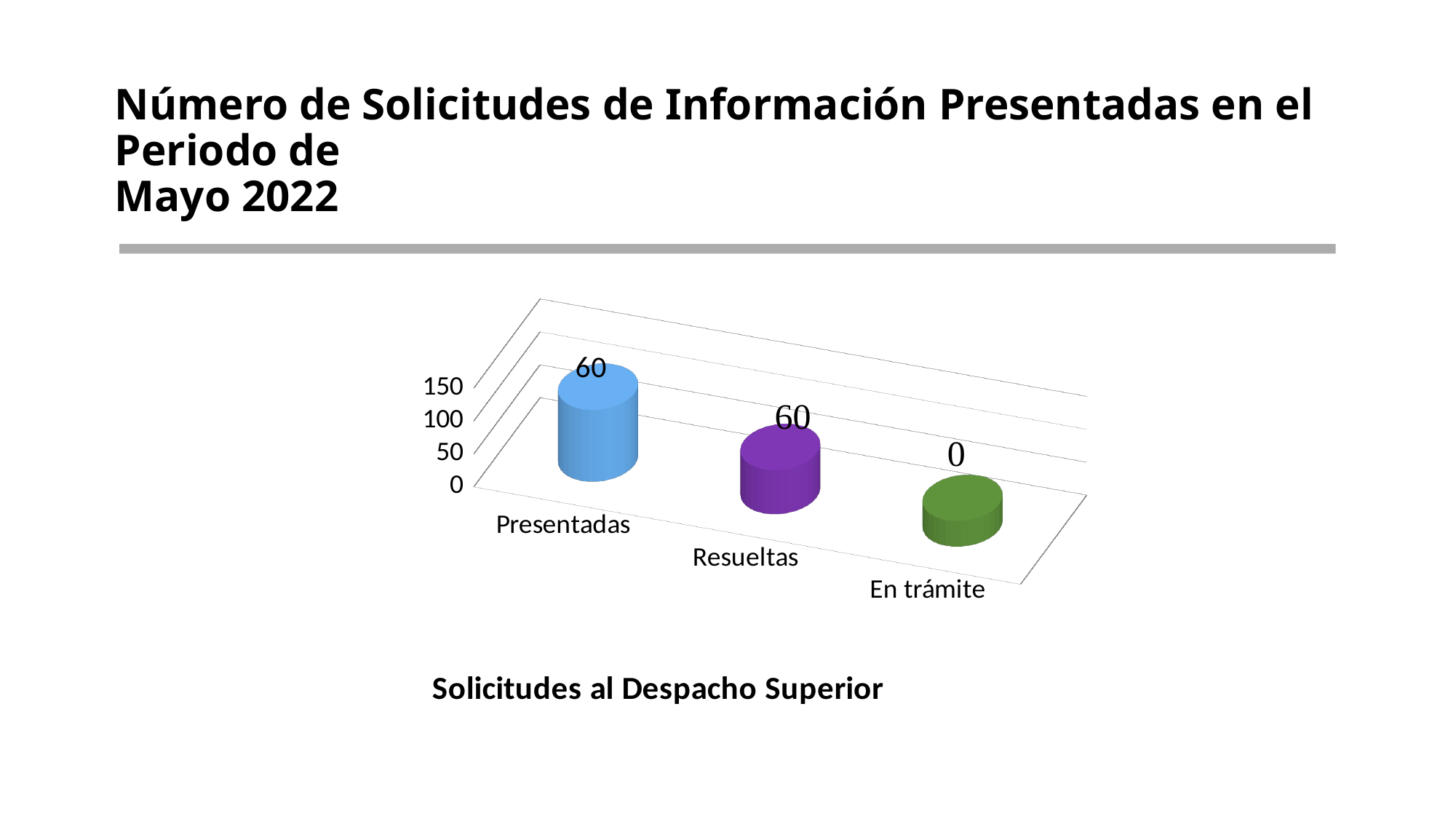
Which is larger, the value for Resueltas or the value for En trámite? Resueltas What is the title shown below the chart? Solicitudes al Despacho Superior How many categories are shown on the x axis? 3 Which category has the lowest value? En trámite Is the value for Presentadas greater or less than 100? greater What is the highest tick value shown on the vertical axis? 150 Do the values rise or fall from Resueltas to En trámite? fall What kind of chart is shown on the slide? bar chart